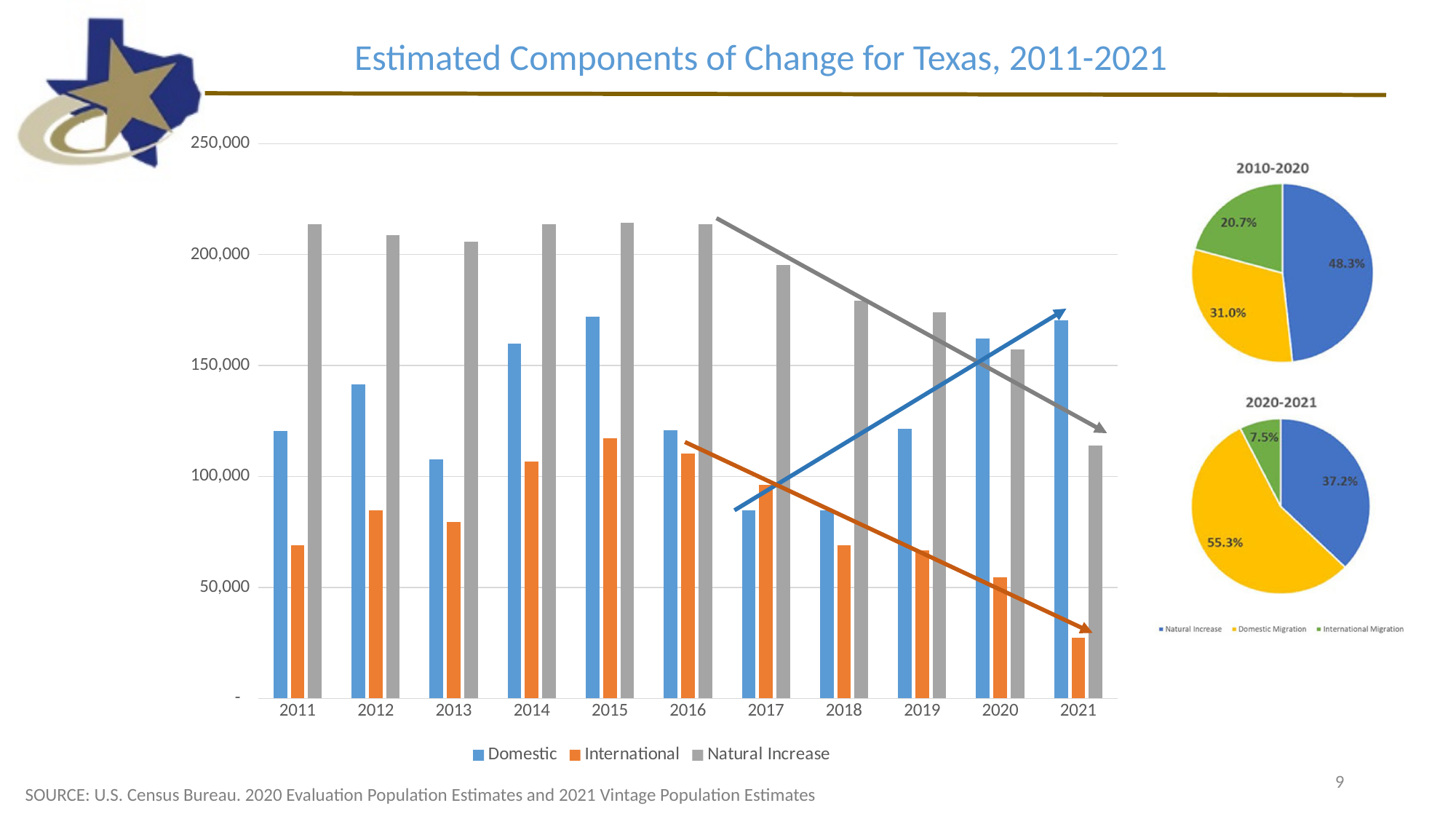
In the bar chart, is the Domestic value for 2020 greater or less than 150,000? greater In the bar chart, is the International value for 2021 greater or less than 50,000? less In the bar chart, which is larger in 2021, Domestic or International? Domestic In the bar chart, which year has the lowest Natural Increase value? 2021 What is the difference between the Domestic Migration share in the 2020-2021 pie chart and in the 2010-2020 pie chart? 24.3 percentage points How many series does the legend of the bar chart list? 3 How many years are shown on the x axis of the bar chart? 11 In the bar chart, does the Natural Increase series generally rise or fall from 2016 to 2021? fall What type of chart is the large chart on the left of the slide? bar chart In the bar chart, is the Natural Increase value for 2011 greater or less than 200,000? greater In the 2020-2021 pie chart, which component has the largest share? Domestic Migration In the 2010-2020 pie chart, what share is Natural Increase? 48.3%